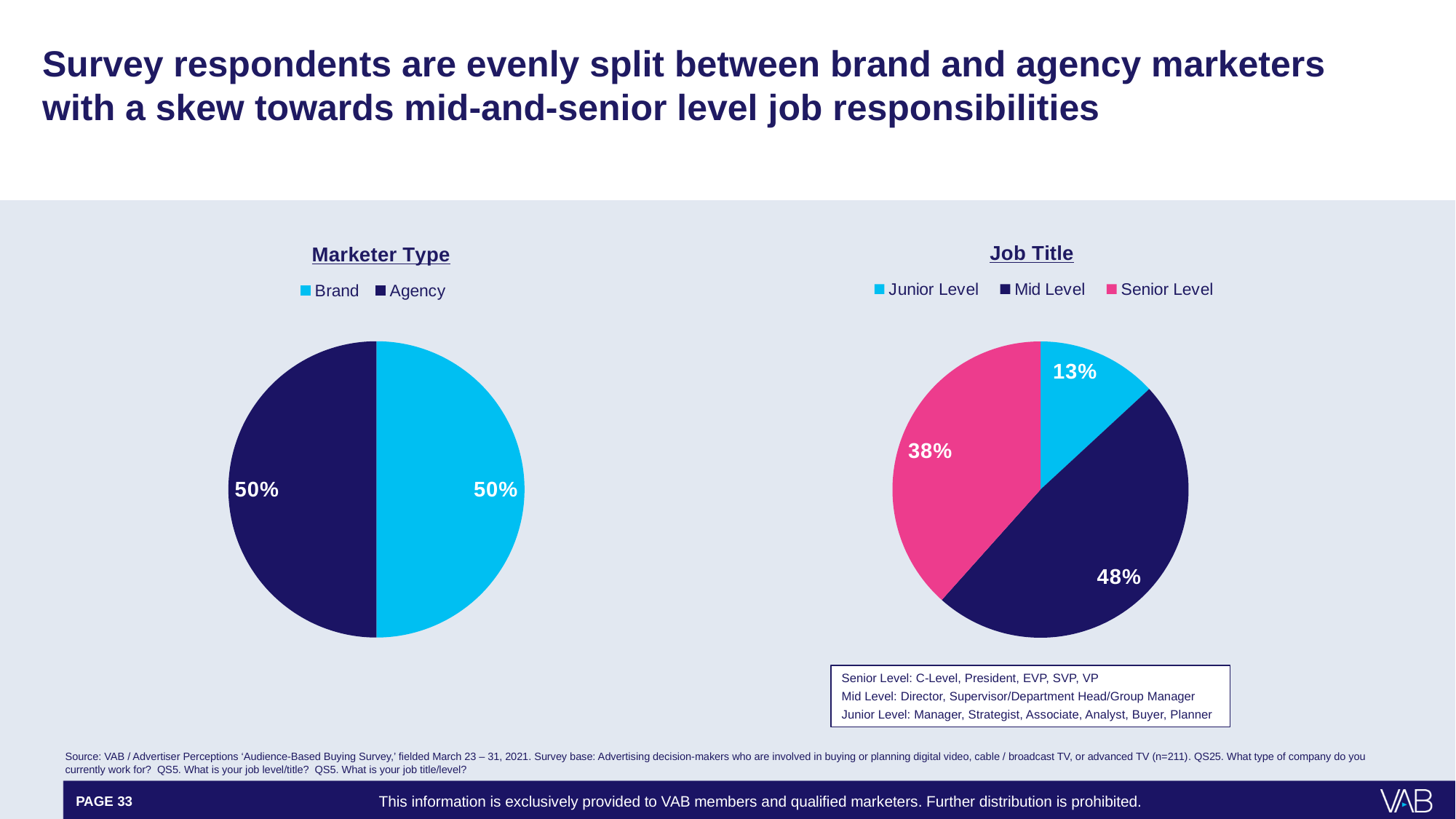
In the Job Title chart, which job level has the largest share? Mid Level In the Job Title chart, what percentage of respondents are Mid Level? 48% In the Job Title chart, what percentage of respondents are Senior Level? 38% In the Job Title chart, what is the difference in percentage points between Mid Level and Junior Level? 35 In the Job Title chart, what percentage of respondents are Junior Level? 13% In the Marketer Type chart, what share of respondents are Agency marketers? 50% In the Job Title chart, which is larger: Senior Level or Junior Level? Senior Level What type of chart is the Marketer Type chart? Pie chart In the Job Title chart, what colour is the Senior Level slice? Pink In the Marketer Type chart, what share of respondents are Brand marketers? 50% How many categories does the Job Title chart's legend list? 3 In the Job Title chart, which job level has the smallest share? Junior Level